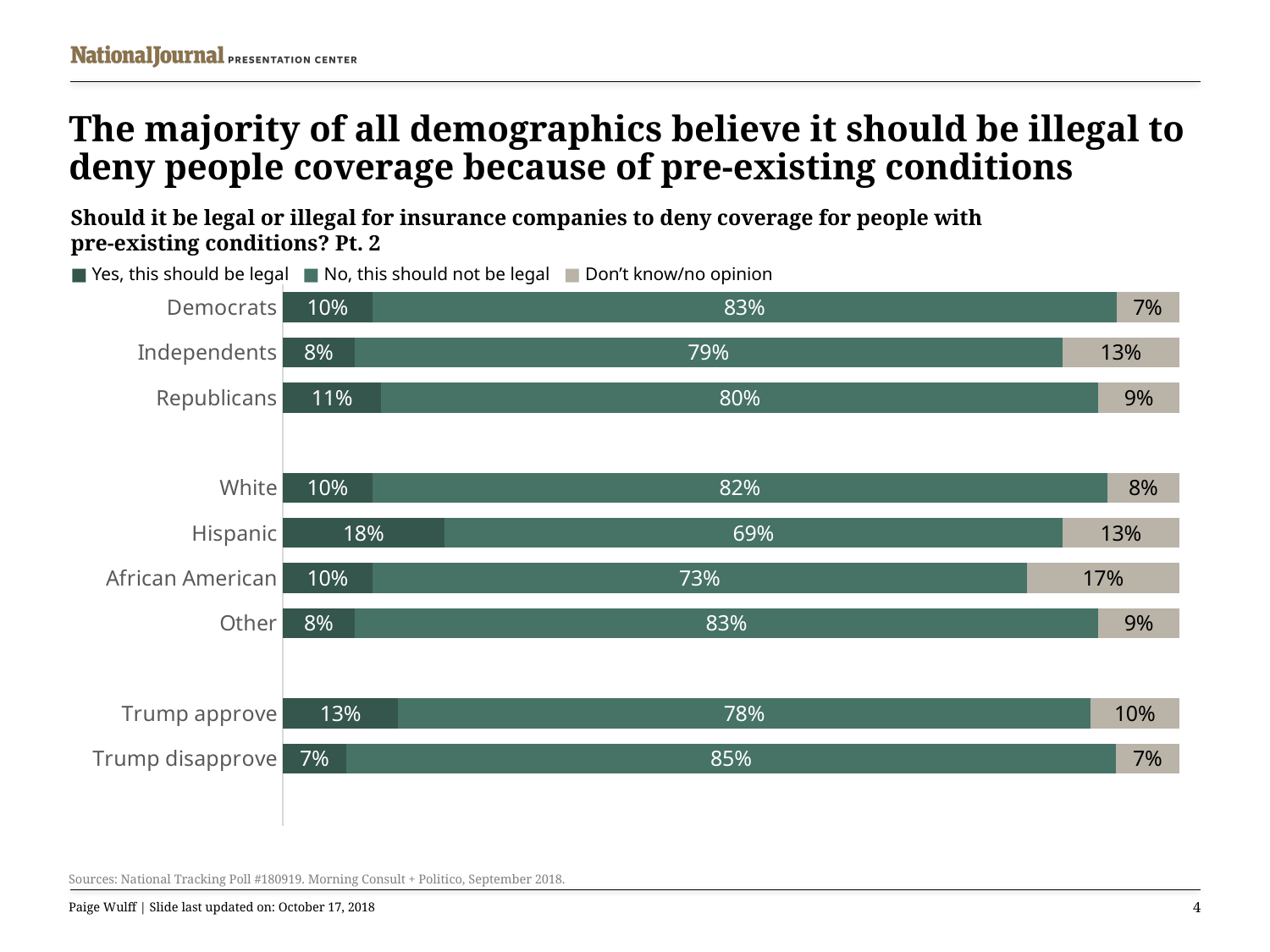
Which category has the lowest share saying 'No, this should not be legal'? Hispanic What percentage of African American respondents answered 'Don't know/no opinion'? 17% Which category has the highest share saying 'No, this should not be legal'? Trump disapprove What percentage of Democrats say it should not be legal to deny coverage for pre-existing conditions? 83% Which legend entry is shown in the lightest (beige) colour? Don't know/no opinion How many demographic categories are shown in the chart? 9 What kind of chart is shown on the slide? Stacked bar chart What is the total of the three segments for the Republicans bar? 100% How many series does the legend list? 3 What is the difference between the 'No, this should not be legal' share for Democrats and for Independents? 4 percentage points What percentage of Hispanic respondents say it should be legal to deny coverage? 18% Which is larger: the 'Yes, this should be legal' share for Trump approve or for Trump disapprove? Trump approve